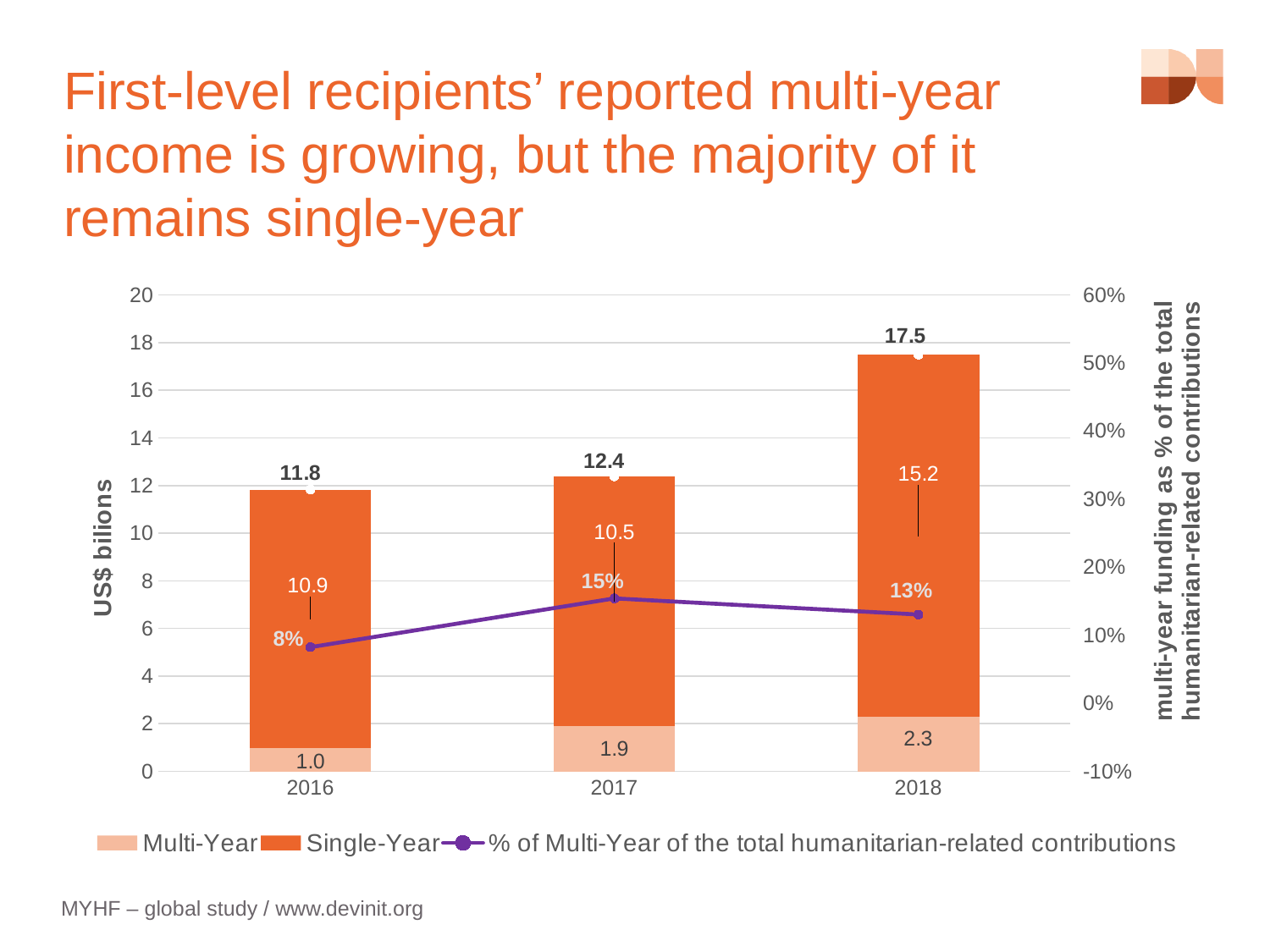
What is the difference between the Single-Year values for 2018 and 2017? 4.7 Which year has the highest total stacked bar? 2018 What is the % of Multi-Year of the total humanitarian-related contributions in 2017? 15% What is the Multi-Year value for 2018? 2.3 How many years are shown on the x axis? 3 What is the total of the stacked bar for 2017? 12.4 Which year has the lowest Multi-Year value? 2016 What is the Single-Year value for 2016? 10.9 What is the label of the left vertical axis? US$ billions Does the total stacked bar value rise or fall from 2016 to 2018? rise How many series does the legend list? 3 Is the Multi-Year value larger in 2017 or 2018? 2018